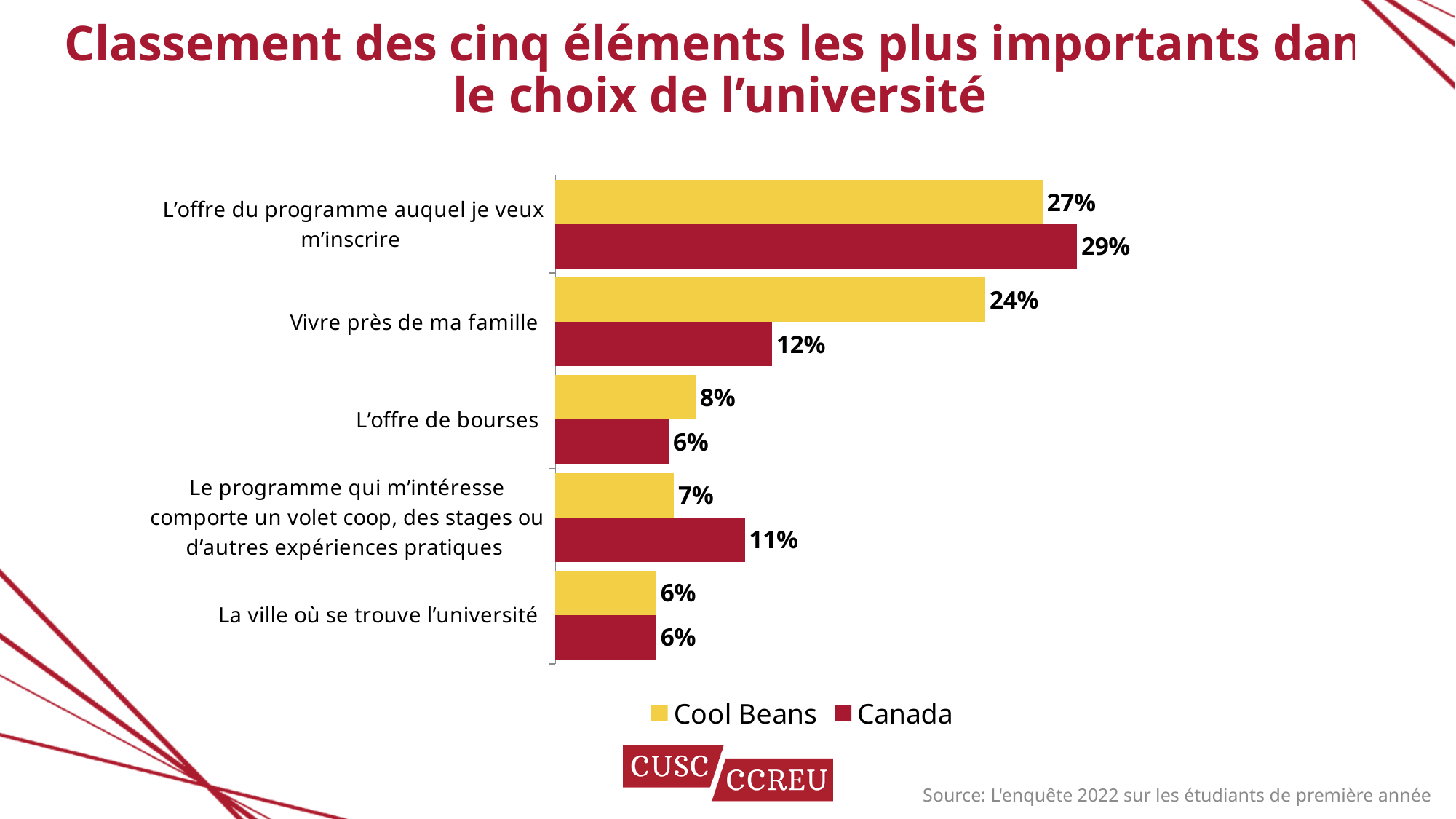
What is the difference between the Canada and Cool Beans values for "L'offre du programme auquel je veux m'inscrire"? 2% What is the Cool Beans value for "Vivre près de ma famille"? 24% What is the Canada value for "Le programme qui m'intéresse comporte un volet coop, des stages ou d'autres expériences pratiques"? 11% How many series does the legend list? 2 What is the Cool Beans value for "L'offre de bourses"? 8% Which is larger for "L'offre de bourses": the Cool Beans value or the Canada value? Cool Beans Which category has the lowest Cool Beans value? La ville où se trouve l'université How many categories are shown in the chart? 5 What is the difference between the Cool Beans and Canada values for "Vivre près de ma famille"? 12% What kind of chart is shown on the slide? Bar chart Which category has the highest Canada value? L'offre du programme auquel je veux m'inscrire What is the Canada value for "L'offre du programme auquel je veux m'inscrire"? 29%